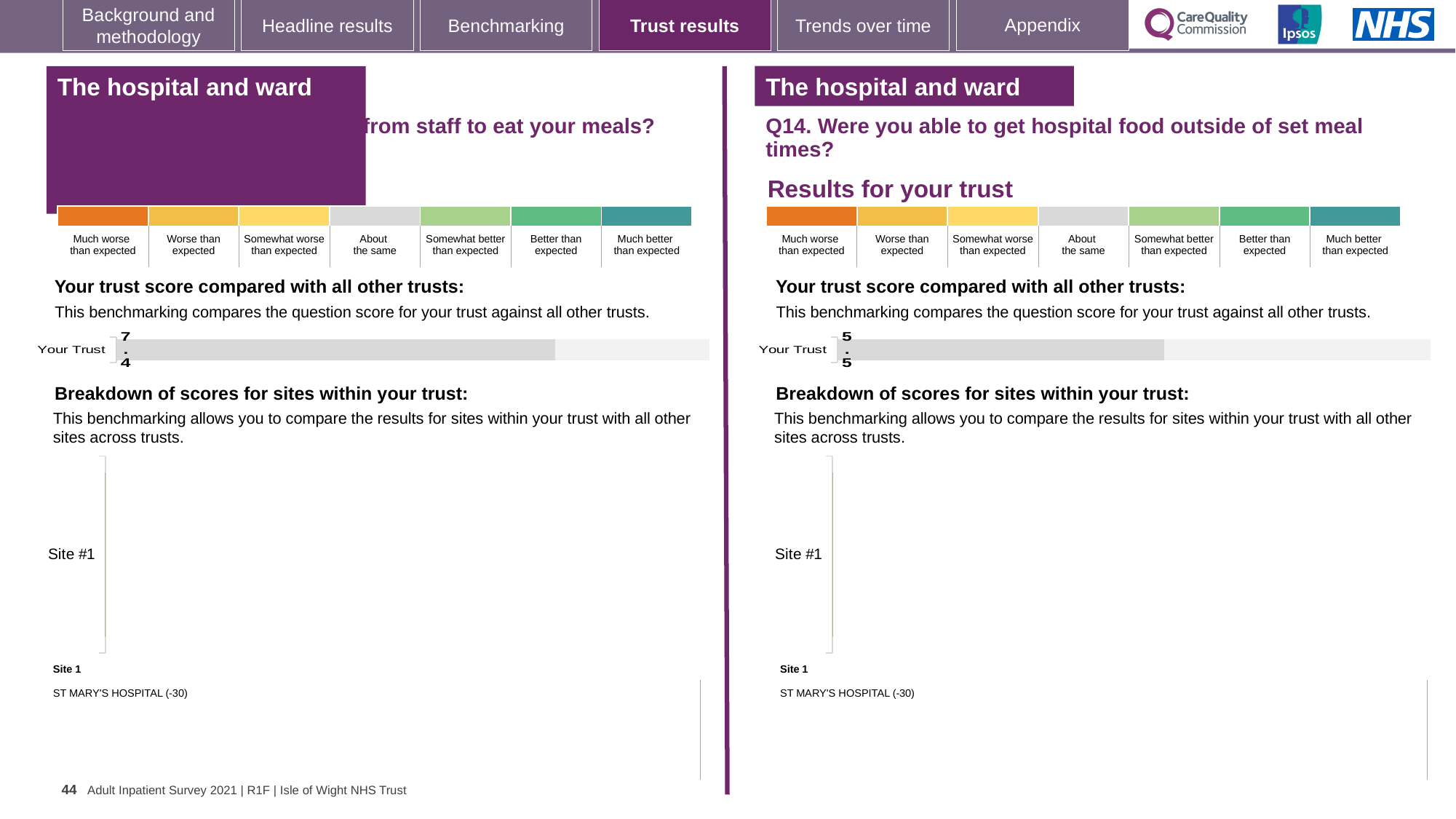
On the right-hand panel (Q14), which site is listed as Site 1 in the breakdown of scores for sites within your trust? ST MARY'S HOSPITAL (-30) On the left-hand panel, what is the score shown for Your Trust? 7.4 What is the difference between the Your Trust score on the left-hand panel and the Your Trust score on the right-hand panel (Q14)? 1.9 Which panel shows the higher Your Trust score, the left-hand panel or the right-hand panel (Q14)? the left-hand panel How many bars are plotted in the 'Your trust score compared with all other trusts' chart on the right-hand panel (Q14)? 1 What kind of chart is used to show the Your Trust score on the right-hand panel (Q14)? bar chart How many rating categories does the colour key above the charts on the right-hand panel (Q14) list? 7 On the right-hand panel (Q14), what is the score shown for Your Trust? 5.5 What is the full question text shown on the right-hand panel? Q14. Were you able to get hospital food outside of set meal times? On the right-hand panel (Q14), what colour represents 'Much worse than expected' in the colour key? orange